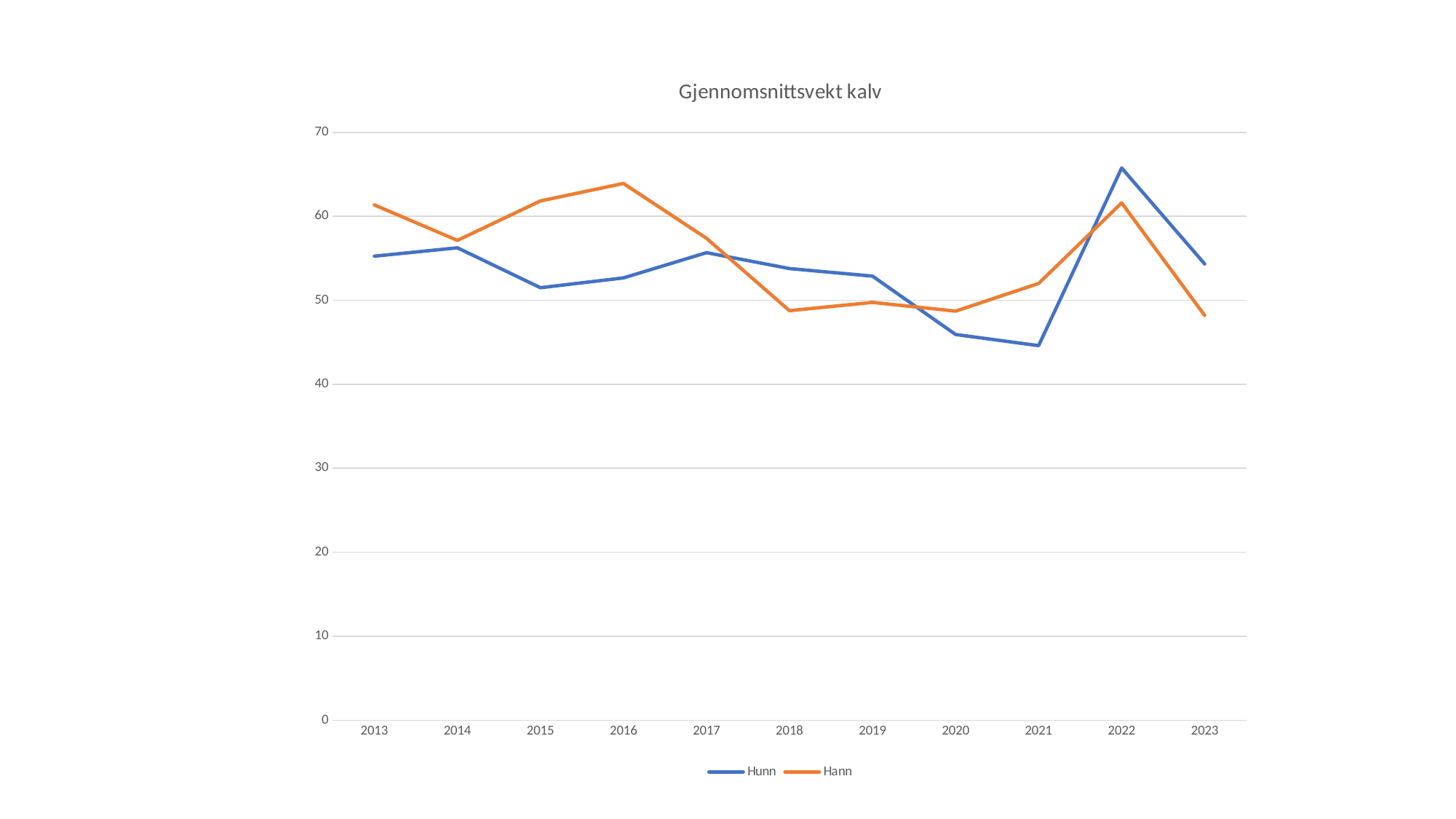
Is the value for Hunn in 2021 greater or less than 50? less In which year does the Hunn series reach its lowest value? 2021 How many series does the legend list? 2 How many years are shown on the x axis? 11 Is the value for Hann in 2023 greater or less than 50? less Is the value for Hann in 2016 greater or less than 60? greater In which year does the Hann series reach its highest value? 2016 What type of chart is shown on the slide? Line chart Which series has the larger value in 2016, Hunn or Hann? Hann What is the title of the chart? Gjennomsnittsvekt kalv Does the Hunn series rise or fall from 2017 to 2021? Fall In which year does the Hunn series reach its highest value? 2022